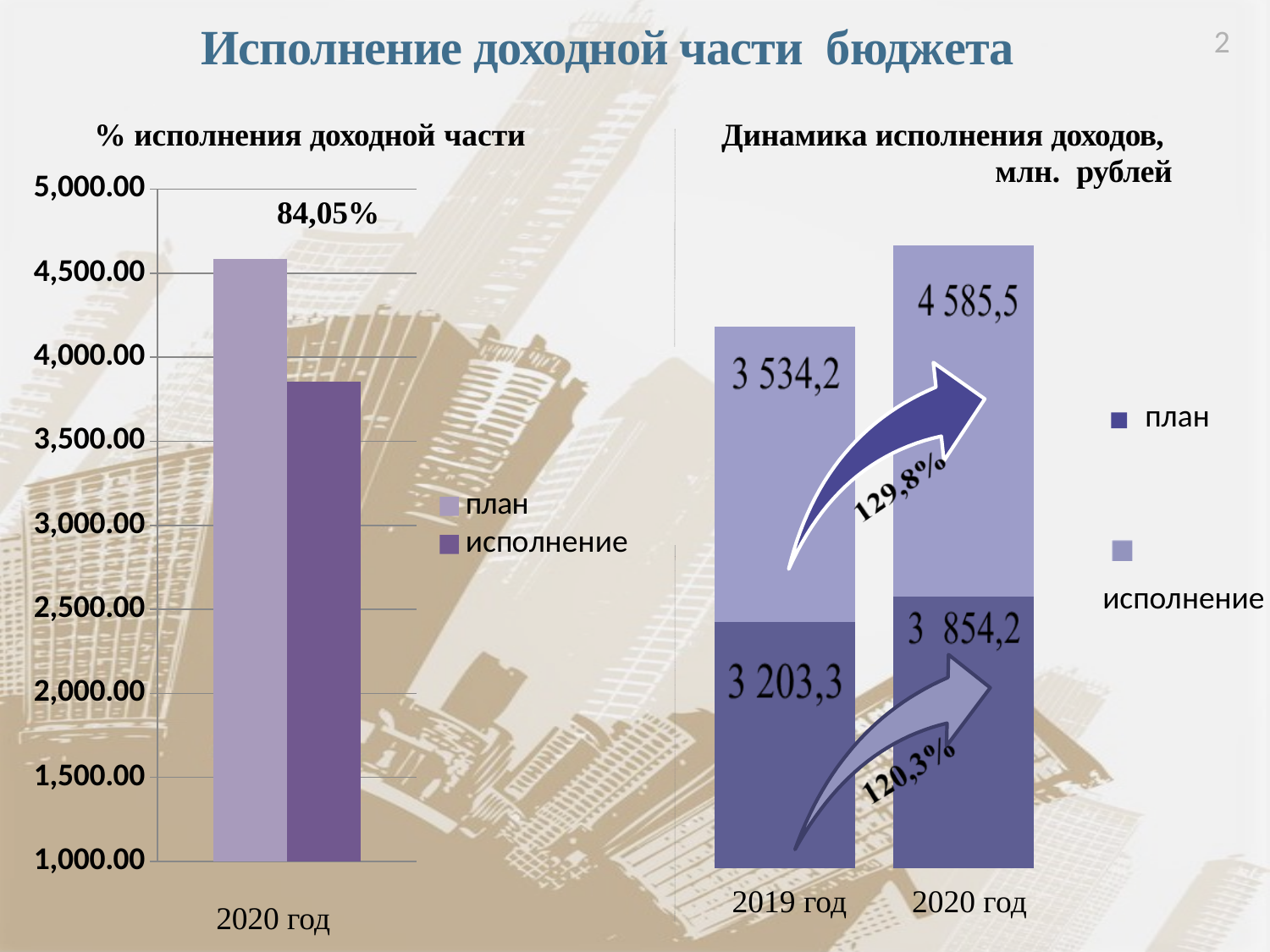
On the left chart '% исполнения доходной части', is the value for план greater or less than 4,000.00? greater On the left chart '% исполнения доходной части', which series has the taller bar, план or исполнение? план On the left chart titled '% исполнения доходной части', what percentage label is shown above the bars for 2020 год? 84,05% On the left chart '% исполнения доходной части', is the value for исполнение greater or less than 4,000.00? less On the right chart 'Динамика исполнения доходов, млн. рублей', do the исполнение values rise or fall from 2019 год to 2020 год? rise What kind of chart is the right chart 'Динамика исполнения доходов, млн. рублей'? bar chart How many series does the legend of the left chart '% исполнения доходной части' list? 2